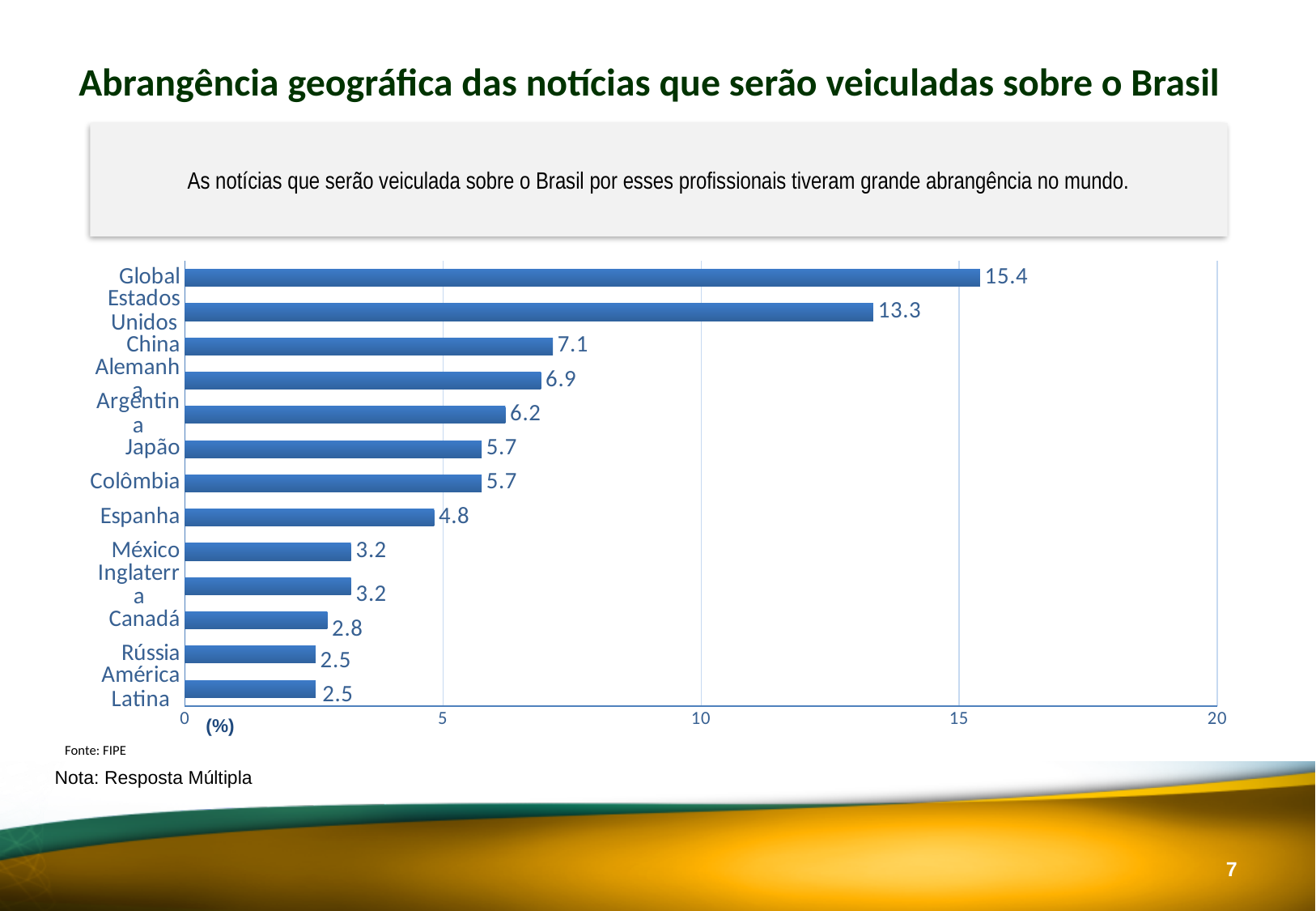
What is the value for Canadá? 2.8 How many categories are shown in the chart? 13 What kind of chart is shown on the slide? Bar chart What is the value for Estados Unidos? 13.3 What is the source cited below the chart? FIPE Which is larger, the value for Argentina or the value for Espanha? Argentina What is the difference between the values for China and Alemanha? 0.2 Which category has the highest value? Global What is the difference between the values for Global and Estados Unidos? 2.1 What is the value for Espanha? 4.8 What is the value for Global? 15.4 Is the value for Estados Unidos greater or less than 10? greater